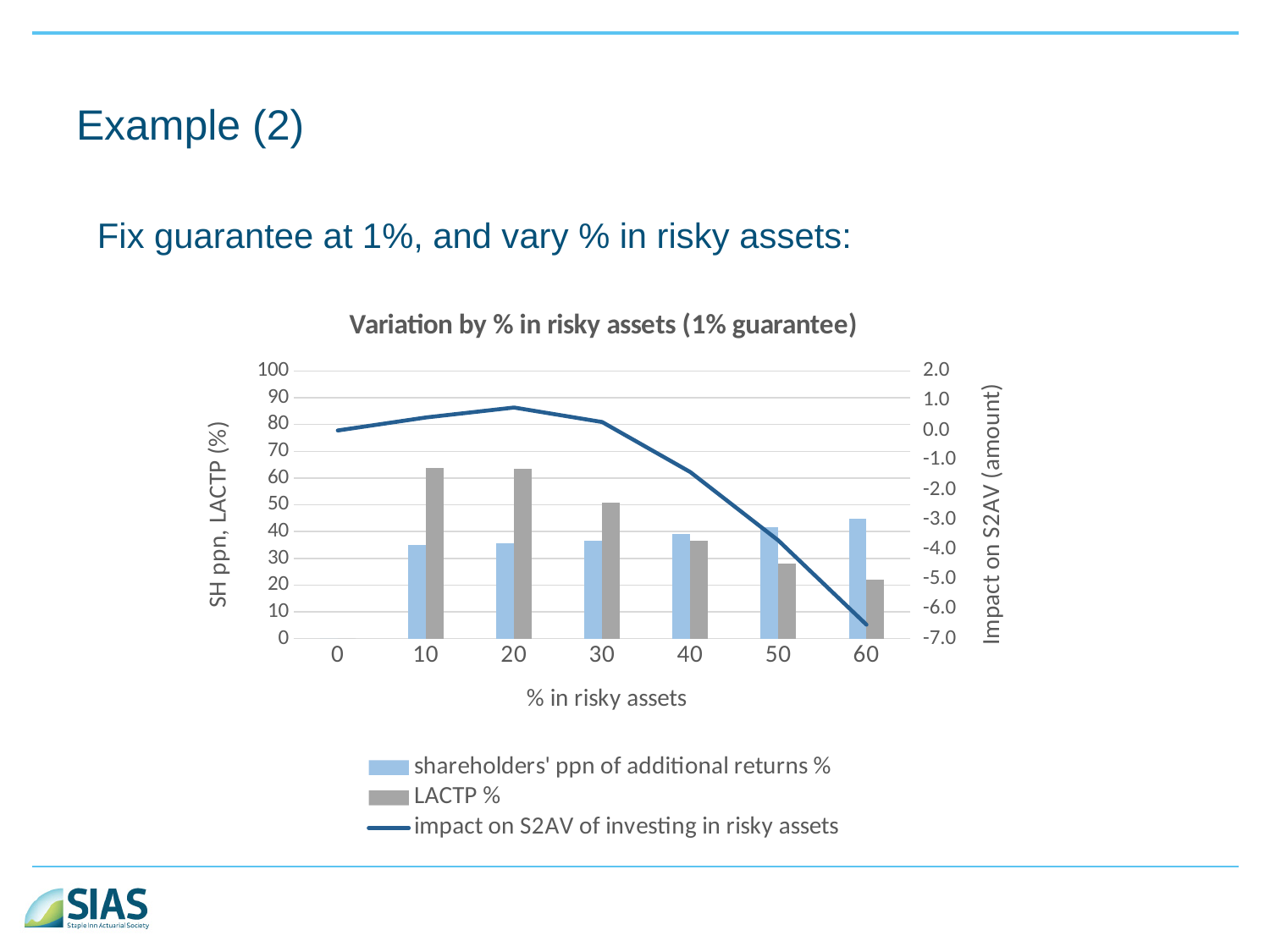
How many series does the legend list? 3 At which % in risky assets does the impact on S2AV line reach its lowest point? 60 Is the LACTP % value at 60% in risky assets greater or less than 30? less Is the LACTP % value at 10% in risky assets greater or less than 60? greater At which % in risky assets is the shareholders' ppn of additional returns % bar highest? 60 What is the title of the chart? Variation by % in risky assets (1% guarantee) What kind of chart is this? Combination bar and line chart How many values of % in risky assets are shown on the x axis? 7 At 10% in risky assets, which bar is taller: shareholders' ppn of additional returns % or LACTP %? LACTP % Does the impact on S2AV line rise or fall between 20 and 60 on the x axis? fall At which % in risky assets is the LACTP % bar lowest? 60 At which % in risky assets does the impact on S2AV line reach its highest point? 20